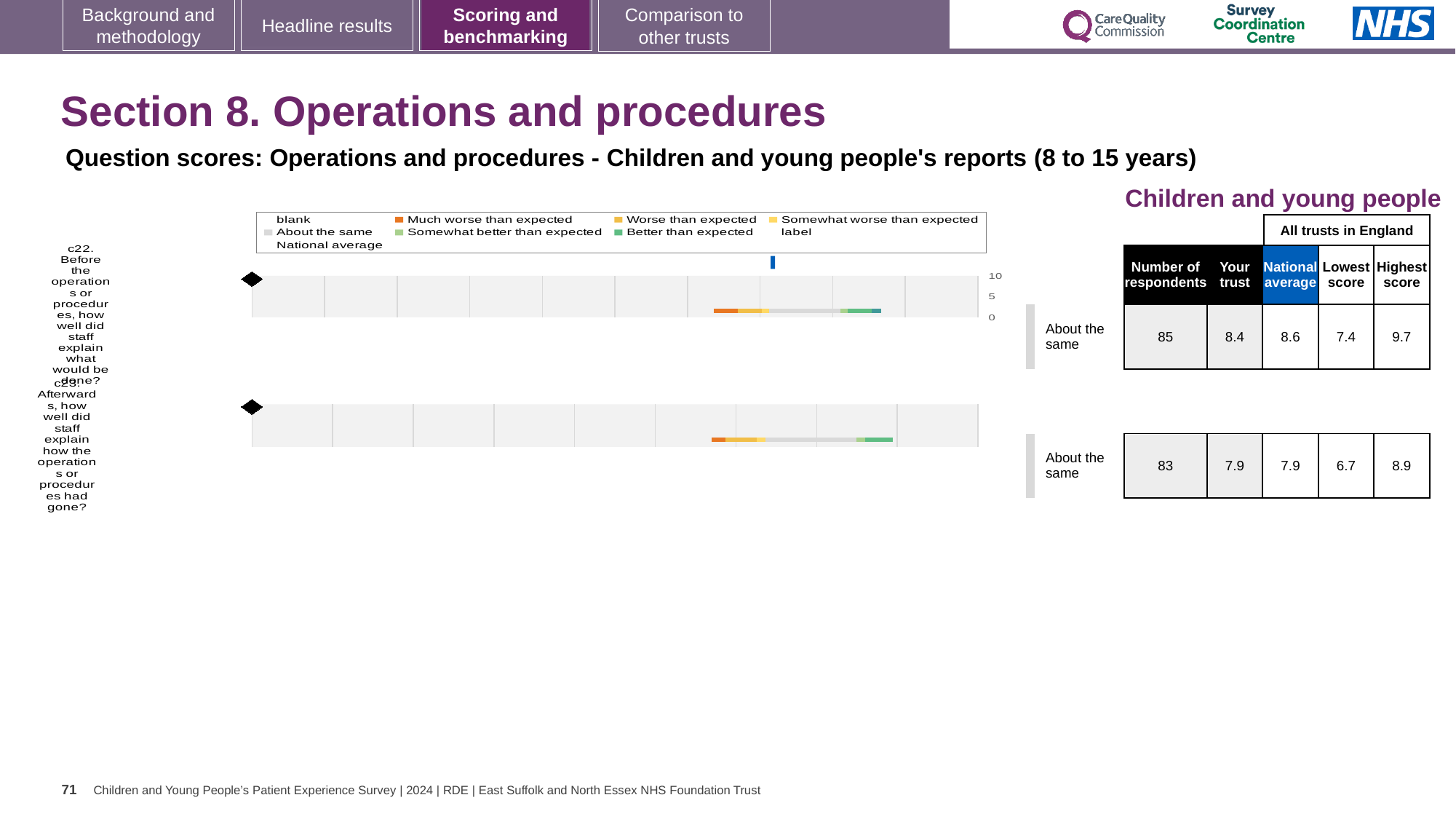
What benchmark category is shown next to the chart for question c22? About the same What kind of chart is used to show the benchmarking results for questions c22 and c23? bar chart How many respondents answered question c23? 83 For question c22 (Before the operations or procedures, how well did staff explain what would be done?), what is the 'Your trust' score shown in the table? 8.4 Which question had more respondents, c22 or c23? c22 For question c23, what is the lowest score among all trusts in England? 6.7 For question c22, what is the difference between the highest score and the lowest score across all trusts in England? 2.3 For question c23 (Afterwards, how well did staff explain how the operations or procedures had gone?), what is the 'Your trust' score? 7.9 For question c23, what is the difference between the highest score and the lowest score across all trusts in England? 2.2 How many survey questions are plotted on the slide? 2 For question c22, what is the national average score shown? 8.6 For question c22, which is larger: the 'Your trust' score or the national average? National average